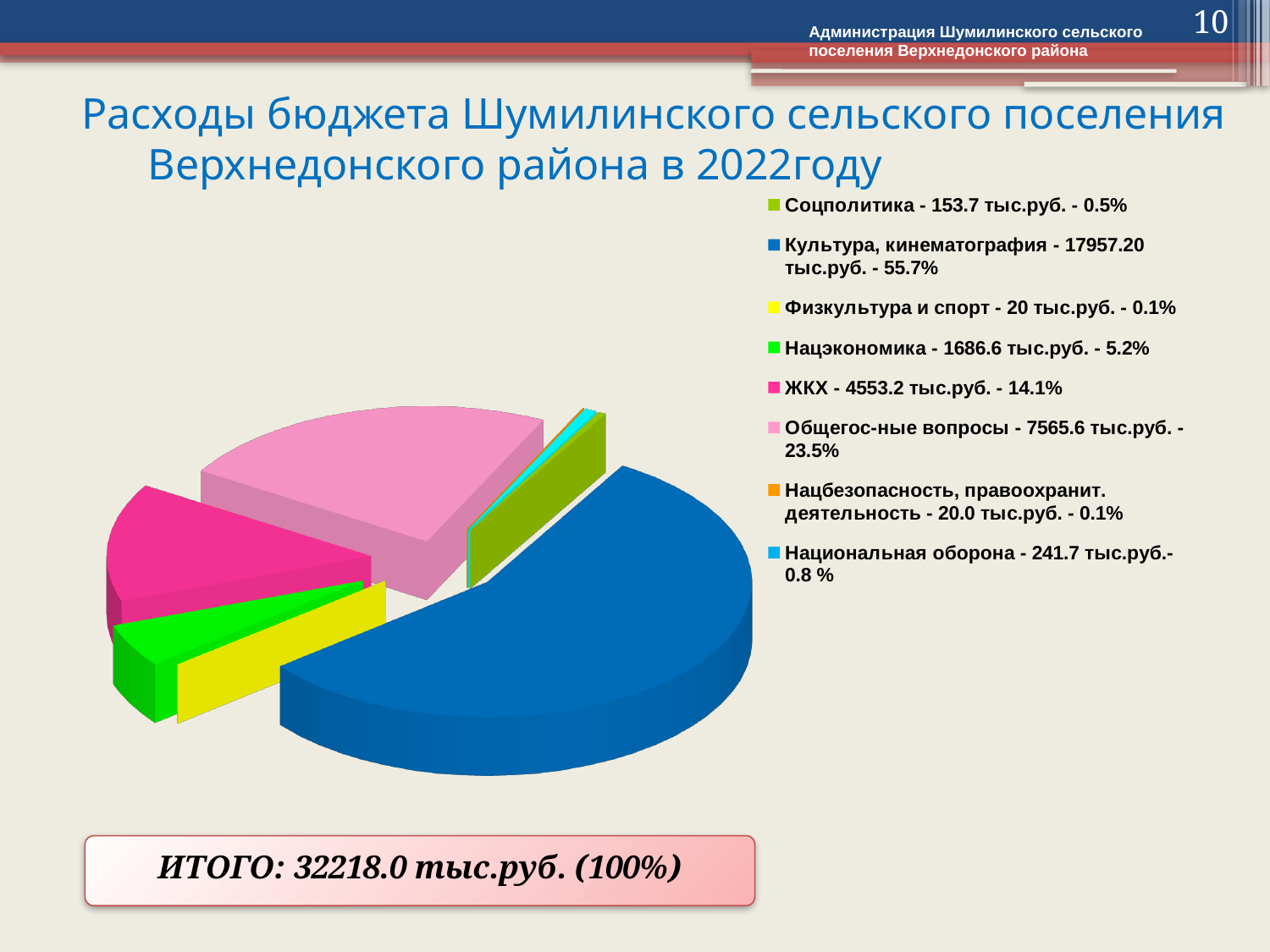
What share of the pie does Нацэкономика represent? 5.2% What is the value for Национальная оборона? 241.7 тыс.руб. Which is larger, the value for ЖКХ or the value for Общегос-ные вопросы? Общегос-ные вопросы What colour is the slice for Соцполитика in the legend? olive green What is the difference between the values for Общегос-ные вопросы and ЖКХ? 3012.4 тыс.руб. What is the total budget expenditure shown on the slide (ИТОГО)? 32218.0 тыс.руб. Which category has the largest share of the pie? Культура, кинематография How many categories does the legend of the pie chart list? 8 What is the value for Культура, кинематография? 17957.20 тыс.руб. What is the value for Общегос-ные вопросы? 7565.6 тыс.руб. What type of chart is shown on the slide? pie chart What share of the pie does ЖКХ represent? 14.1%